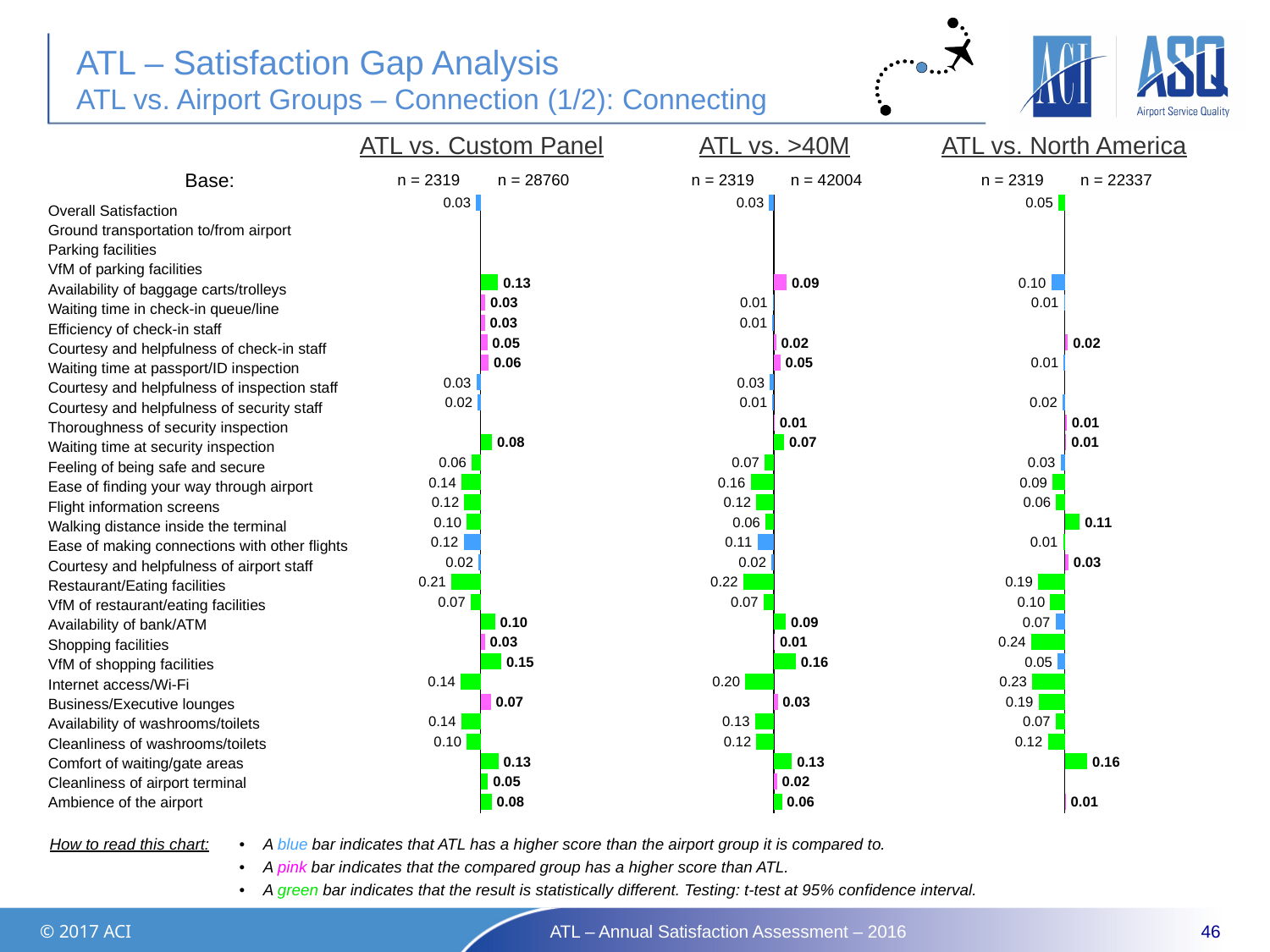
In the ATL vs. >40M chart, which item has the largest value? Restaurant/Eating facilities In the ATL vs. >40M chart, what is the value shown for Comfort of waiting/gate areas? 0.13 In the ATL vs. North America chart, what is the value shown for Shopping facilities? 0.24 What is the base sample size (n) shown for the comparison group in the ATL vs. >40M chart? n = 42004 In the ATL vs. Custom Panel chart, what is the difference between the values for VfM of shopping facilities and Shopping facilities? 0.12 In the ATL vs. Custom Panel chart, what is the value shown for Restaurant/Eating facilities? 0.21 In the ATL vs. >40M chart, what is the value shown for Internet access/Wi-Fi? 0.20 According to the 'How to read this chart' note, what does a green bar indicate? The result is statistically different In the ATL vs. Custom Panel chart, what is the value shown for Availability of baggage carts/trolleys? 0.13 In the ATL vs. North America chart, which is larger: the value for Internet access/Wi-Fi or the value for Business/Executive lounges? Internet access/Wi-Fi In the ATL vs. North America chart, which item has the largest value? Shopping facilities What kind of chart is used for the ATL vs. Custom Panel comparison? Bar chart